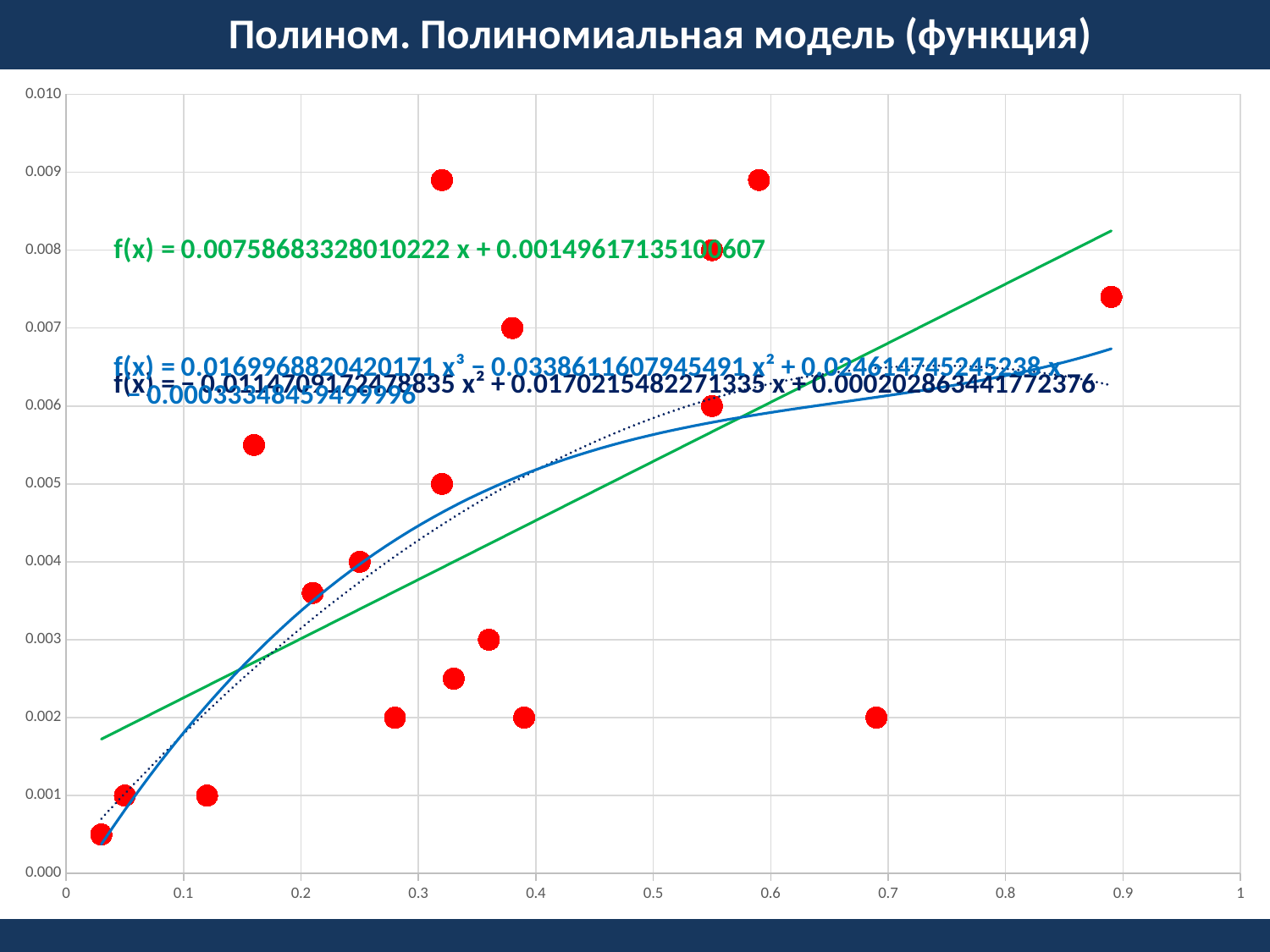
What is the y value of the data point at x = 0.38? 0.007 What kind of chart is shown on the slide? Scatter chart Is the y value of the rightmost data point (at x ≈ 0.89) greater or less than 0.007? greater What is the equation of the green linear trendline shown on the chart? f(x) = 0.00758683328010222 x + 0.00149617135100607 What is the y value of the data point at x = 0.69? 0.002 What is the title of the slide containing the chart? Полином. Полиномиальная модель (функция) What is the y value of the data point at x = 0.25? 0.004 Is the y value of the data point at x ≈ 0.16 greater or less than 0.005? greater Which data point has the lowest y value: the one at x ≈ 0.03 or the one at x ≈ 0.69? The one at x ≈ 0.03 What is the y value of the data point at x = 0.12? 0.001 Does the green linear trendline rise or fall as x increases? Rises